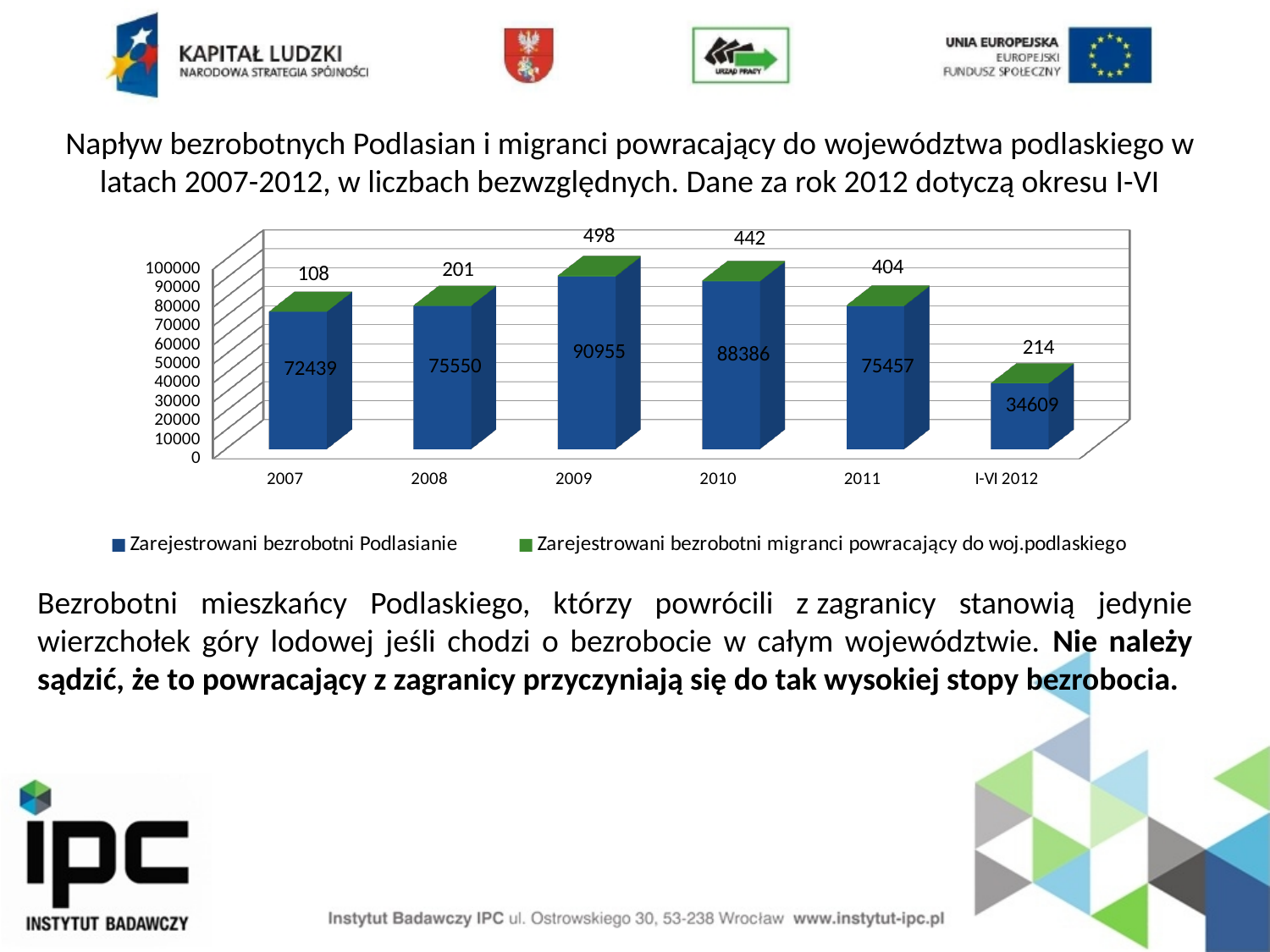
Which period has the highest value for Zarejestrowani bezrobotni Podlasianie? 2009 What is the value for Zarejestrowani bezrobotni Podlasianie in I-VI 2012? 34609 Which colour represents Zarejestrowani bezrobotni migranci powracający do woj.podlaskiego? Green What is the total of the stacked bar for 2007? 72547 How many periods are shown on the x axis? 6 What kind of chart is shown on the slide? Stacked bar chart How many series does the legend list? 2 What is the value for Zarejestrowani bezrobotni migranci powracający do woj.podlaskiego in 2010? 442 Which period has the lowest value for Zarejestrowani bezrobotni migranci powracający do woj.podlaskiego? 2007 What is the value for Zarejestrowani bezrobotni Podlasianie in 2009? 90955 Which is larger, the Zarejestrowani bezrobotni migranci value for 2008 or for 2011? 2011 What is the difference between the Zarejestrowani bezrobotni Podlasianie values for 2009 and 2010? 2569